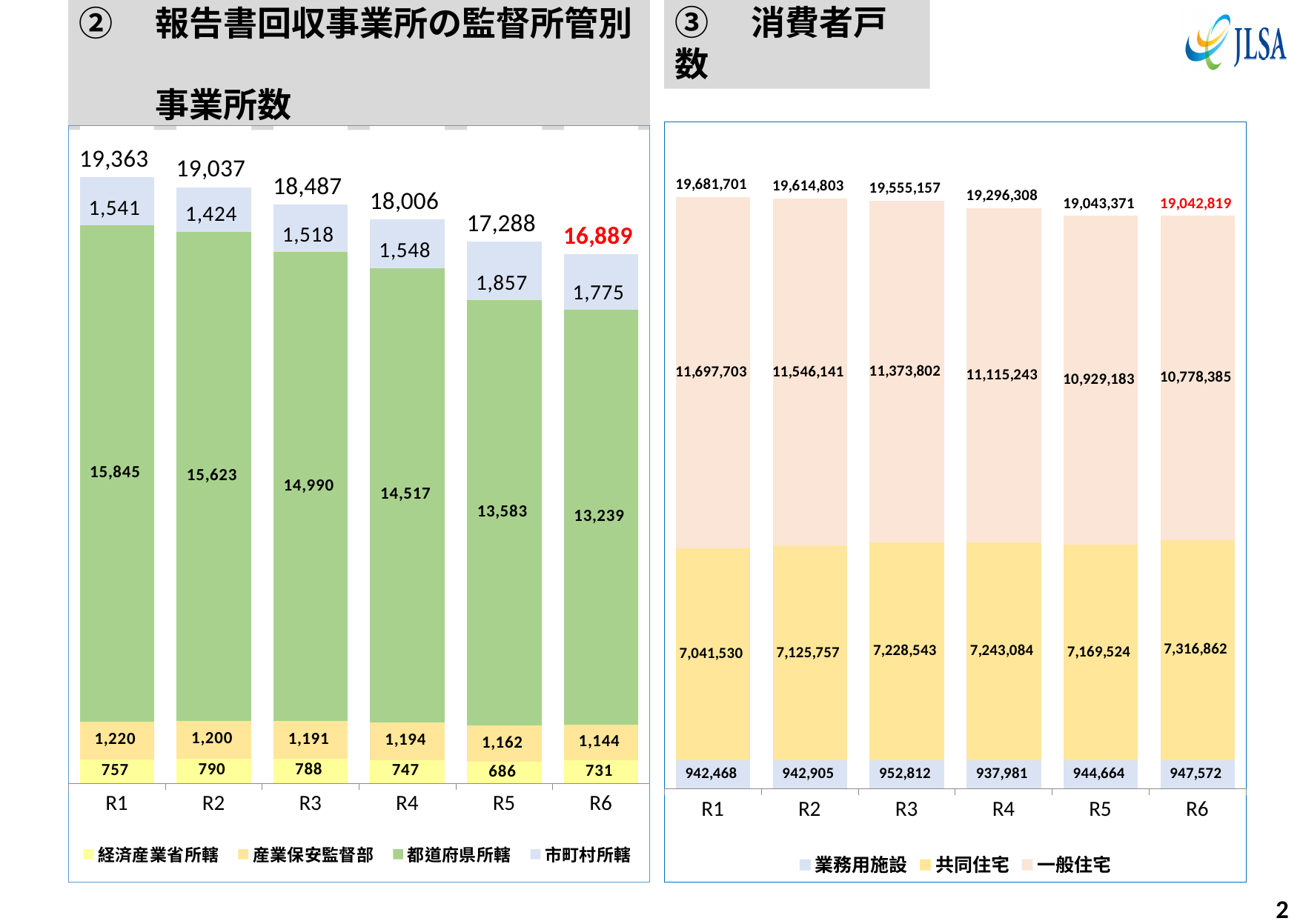
In the left chart (② 報告書回収事業所の監督所管別事業所数), what is the value of 都道府県所轄 for R3? 14,990 In the left chart (② 報告書回収事業所の監督所管別事業所数), which is larger, the 経済産業省所轄 value for R2 or for R5? R2 In the right chart (③ 消費者戸数), what is the total for R1? 19,681,701 In the left chart (② 報告書回収事業所の監督所管別事業所数), what is the total shown above the R6 bar? 16,889 In the left chart (② 報告書回収事業所の監督所管別事業所数), which year has the highest total? R1 In the right chart (③ 消費者戸数), how many years are shown on the x axis? 6 What kind of chart is the right chart (③ 消費者戸数)? stacked bar chart In the right chart (③ 消費者戸数), which year has the lowest 業務用施設 value? R4 In the left chart (② 報告書回収事業所の監督所管別事業所数), how many series does the legend list? 4 In the left chart (② 報告書回収事業所の監督所管別事業所数), what is the difference between the 市町村所轄 values for R5 and R4? 309 In the right chart (③ 消費者戸数), what is the value of 共同住宅 for R6? 7,316,862 In the left chart (② 報告書回収事業所の監督所管別事業所数), do the totals rise or fall from R1 to R6? fall